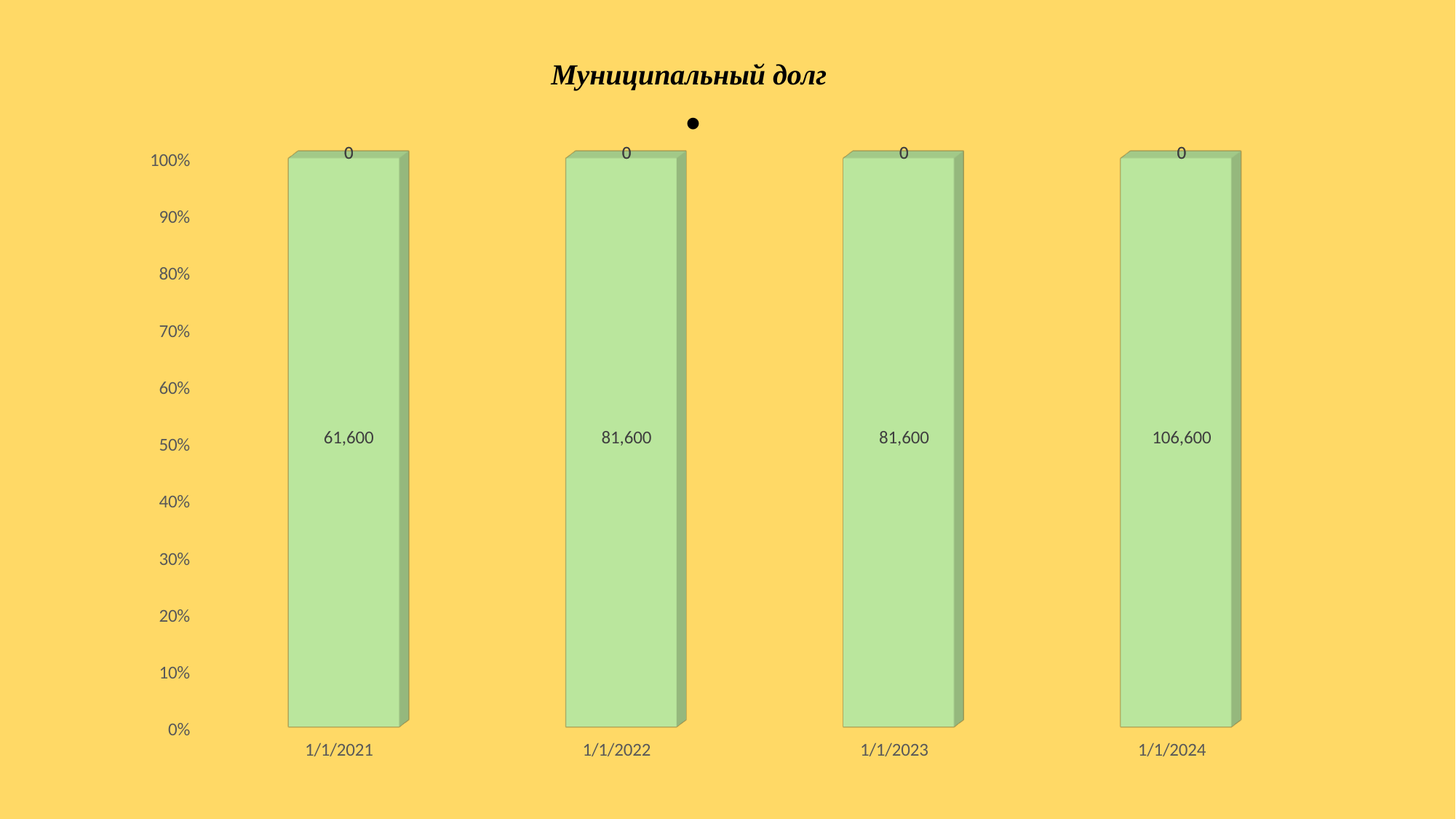
What kind of chart is shown on the slide? Bar chart Which date has the lowest labelled value? 1/1/2021 What is the data label on the bar for 1/1/2022? 81,600 What is the difference between the labelled values for 1/1/2024 and 1/1/2021? 45,000 What is the data label on the bar for 1/1/2024? 106,600 Which has the larger labelled value, 1/1/2024 or 1/1/2022? 1/1/2024 How many dates are shown on the x axis? 4 Which date has the highest labelled value? 1/1/2024 What is the title of the chart? Муниципальный долг What is the data label on the bar for 1/1/2021? 61,600 What is the difference between the labelled values for 1/1/2022 and 1/1/2021? 20,000 What is the data label on the bar for 1/1/2023? 81,600